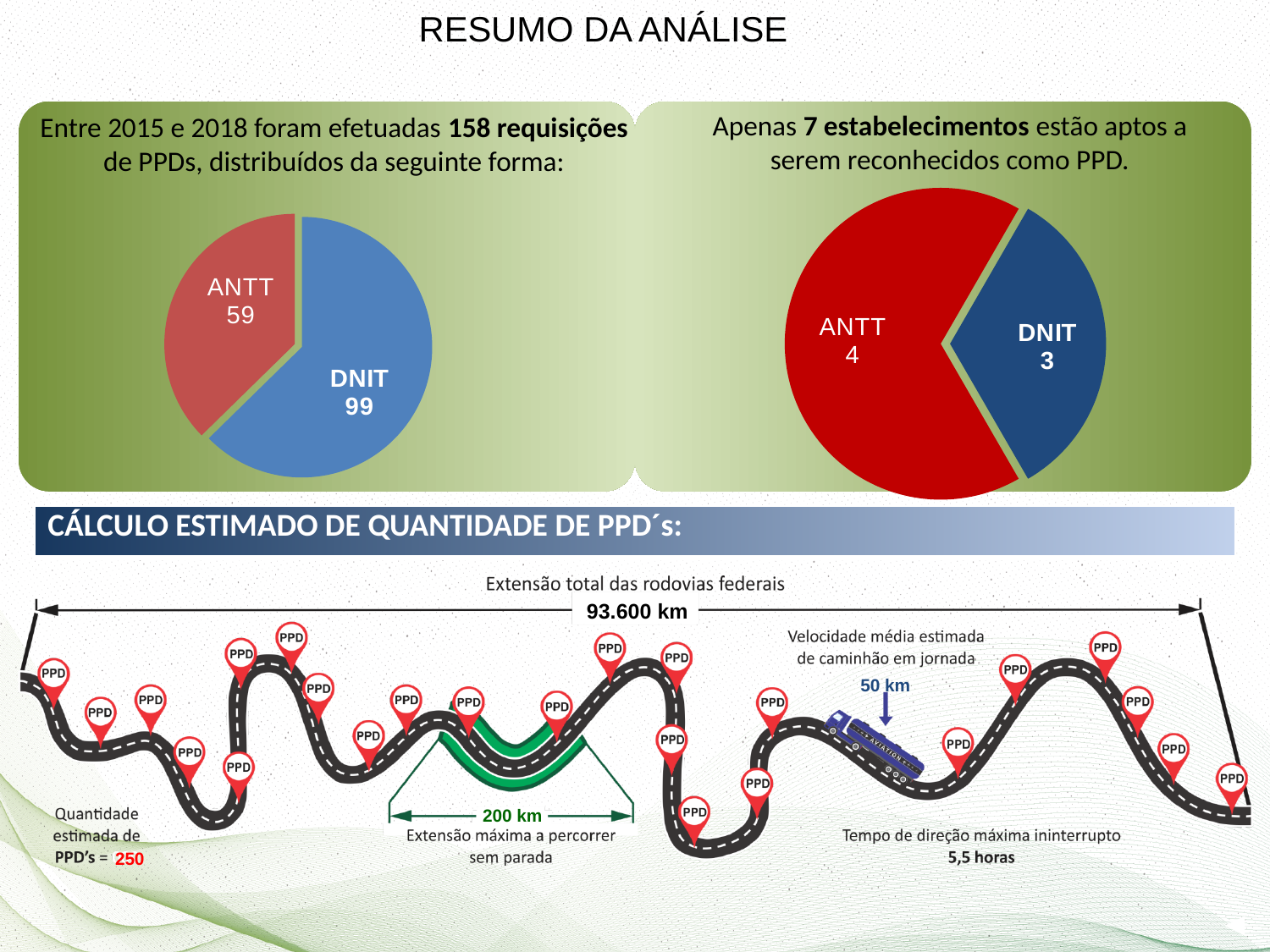
In the left pie chart, what is the total of the two slices? 158 In the right pie chart, which category has the smallest slice? DNIT In the right pie chart, what is the value for DNIT? 3 How many slices does the left pie chart have? 2 In the left pie chart, what is the difference between the DNIT and ANTT values? 40 What type of chart is the right chart on the slide? Pie chart In the left pie chart, what is the value for DNIT? 99 In the right pie chart, what is the value for ANTT? 4 In the right pie chart, is the value for ANTT or DNIT larger? ANTT In the left pie chart, which category has the largest slice? DNIT In the left pie chart, what is the value for ANTT? 59 In the right pie chart, what colour is the ANTT slice? Red